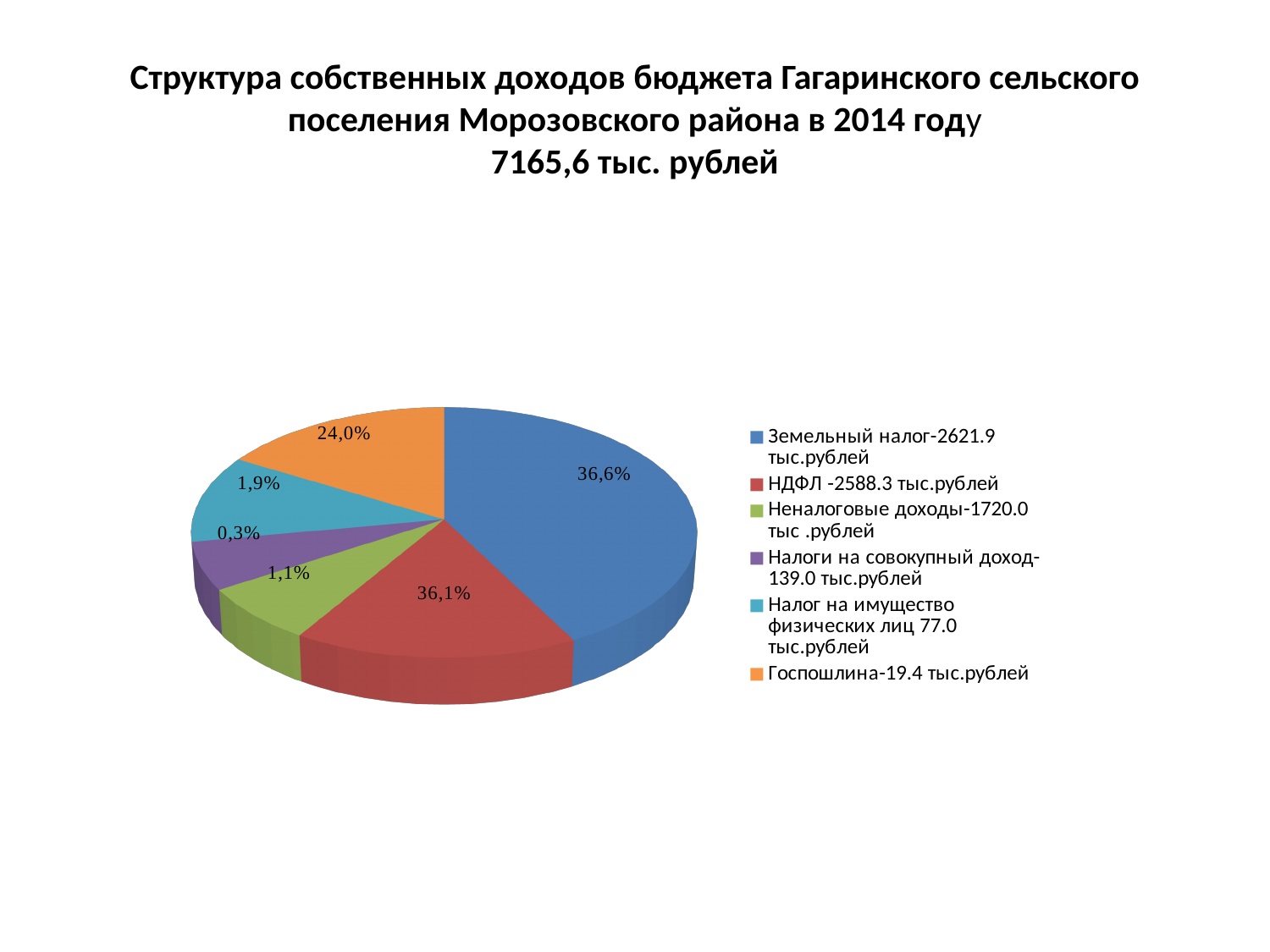
What percentage is shown for the НДФЛ slice? 36,1% What total amount is stated in the chart title? 7165,6 тыс. рублей What kind of chart is shown on the slide? pie chart What amount in тыс. рублей does the legend give for Госпошлина? 19.4 тыс.рублей How many slices does the pie chart have? 6 Which is larger, the Земельный налог slice or the НДФЛ slice? Земельный налог What percentage is shown for the Земельный налог slice? 36,6% Which slice has the largest share of the pie? Земельный налог What is the smallest percentage label shown on the pie chart? 0,3% What percentage label is shown on the orange slice? 24,0% What is the difference between the Земельный налог share and the НДФЛ share? 0,5% How many entries does the legend list? 6